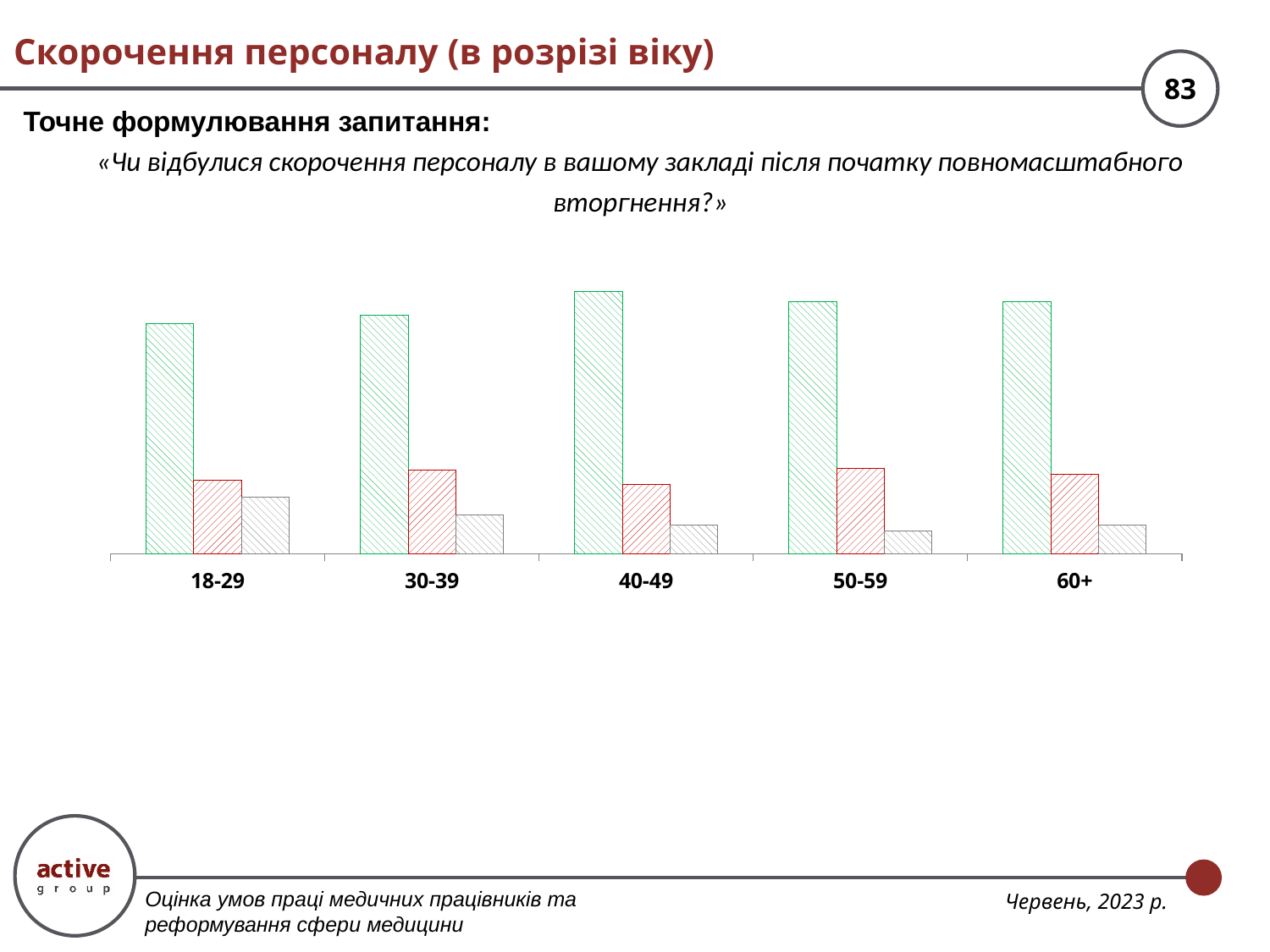
Is the green bar for 40-49 or the green bar for 18-29 taller? 40-49 How many bars are plotted for each age group? 3 Which age group has the tallest grey bar? 18-29 What is the first category label on the x axis of the chart? 18-29 What colour is the tallest bar in every age group? green Which age group has the shortest green bar? 18-29 What kind of chart is shown on the slide? bar chart In the 60+ age group, is the red bar or the grey bar taller? red How many age groups are shown on the x axis of the chart? 5 In the 18-29 age group, is the green bar or the red bar taller? green